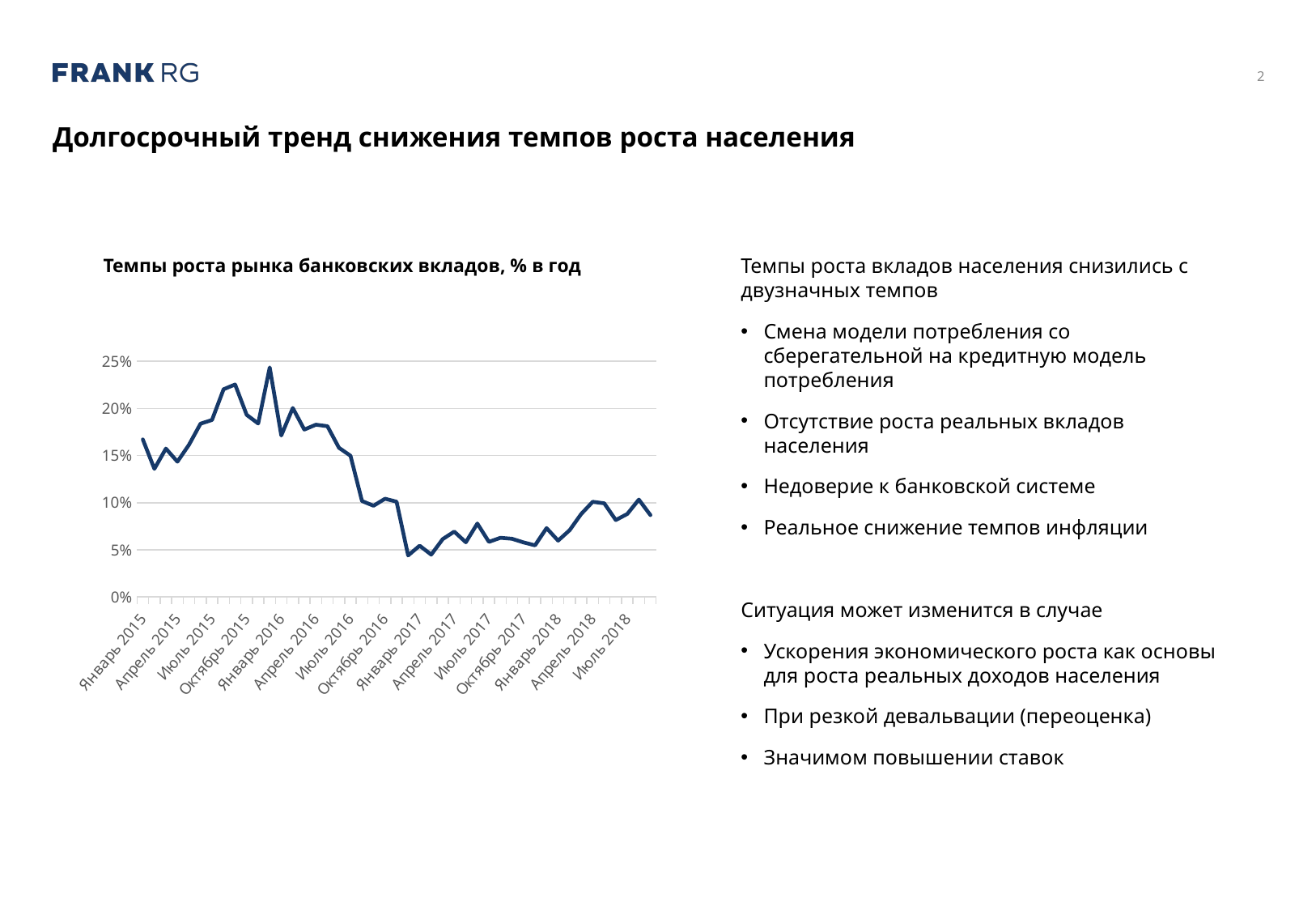
What is the title of the chart? Темпы роста рынка банковских вкладов, % в год Is the value for Январь 2016 greater or less than 20%? less What is the highest tick value shown on the vertical axis? 25% Overall, do the values rise or fall from Январь 2015 to Июль 2018? fall Which is larger, the value for Январь 2016 or the value for Январь 2017? Январь 2016 Which is larger, the value for Январь 2015 or the value for Январь 2018? Январь 2015 Around which labeled date does the line reach its highest value? Январь 2016 What kind of chart is shown on the slide? line chart Is the value for Июль 2017 greater or less than 10%? less Is the value for Январь 2015 greater or less than 15%? greater